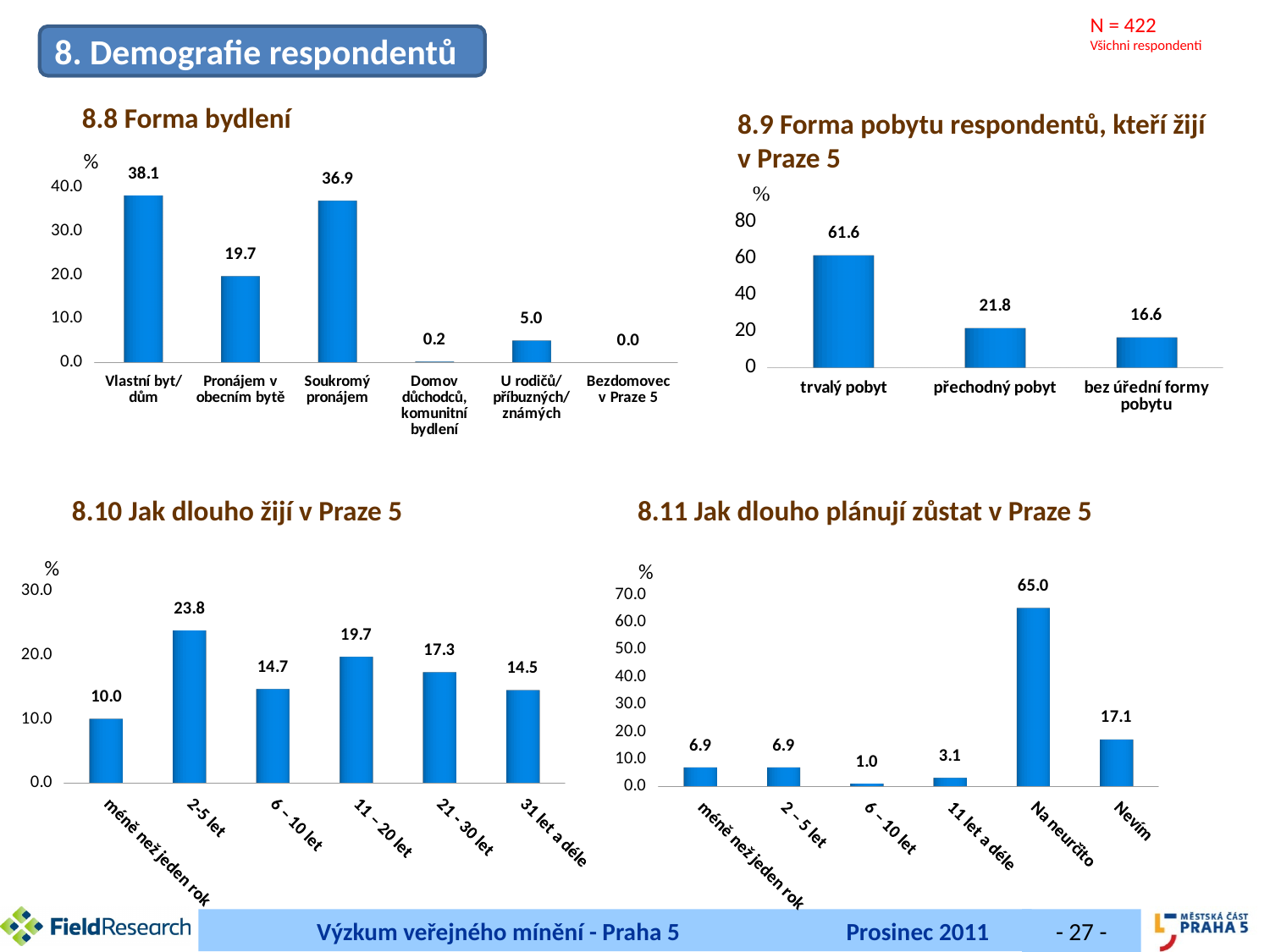
In the chart '8.10 Jak dlouho žijí v Praze 5', which is larger: '21 - 30 let' or '31 let a déle'? 21 - 30 let What type of chart is '8.11 Jak dlouho plánují zůstat v Praze 5'? bar chart In the chart '8.8 Forma bydlení', what is the difference between 'Vlastní byt/ dům' and 'Soukromý pronájem'? 1.2 In the chart '8.8 Forma bydlení', what is the value for 'Vlastní byt/ dům'? 38.1 In the chart '8.9 Forma pobytu respondentů, kteří žijí v Praze 5', what is the value for 'přechodný pobyt'? 21.8 In the chart '8.8 Forma bydlení', which category has the lowest value? Bezdomovec v Praze 5 In the chart '8.10 Jak dlouho žijí v Praze 5', which category has the highest value? 2-5 let In the chart '8.10 Jak dlouho žijí v Praze 5', what is the value for '11 – 20 let'? 19.7 In the chart '8.11 Jak dlouho plánují zůstat v Praze 5', what is the value for 'Na neurčito'? 65.0 In the chart '8.9 Forma pobytu respondentů, kteří žijí v Praze 5', which category has the highest value? trvalý pobyt In the chart '8.11 Jak dlouho plánují zůstat v Praze 5', which category has the lowest value? 6 – 10 let How many categories are shown in the chart '8.9 Forma pobytu respondentů, kteří žijí v Praze 5'? 3